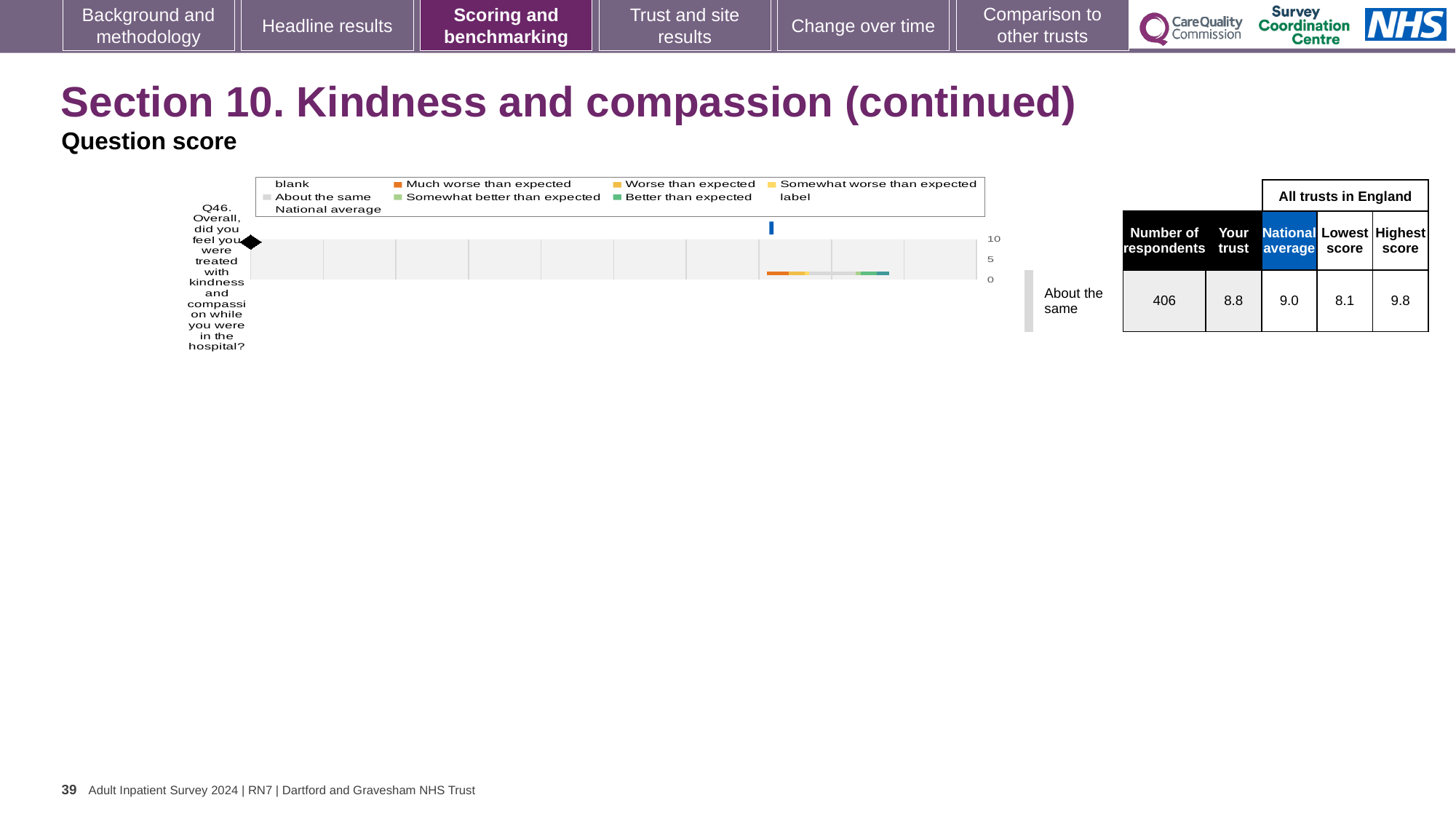
What kind of chart is shown for Q46 on the slide? bar chart Which is larger for Q46: the 'Your trust' score or the national average? National average How many respondents answered Q46? 406 What is the 'Your trust' score for Q46? 8.8 What is the lowest score among all trusts in England for Q46? 8.1 What is the difference between the highest score and the lowest score for Q46? 1.7 What is the national average score for Q46? 9.0 Is the 'Your trust' score for Q46 greater or less than 5? greater What is the highest score among all trusts in England for Q46? 9.8 How many survey questions are plotted in the chart? 1 What benchmark category is the trust's Q46 result placed in? About the same What is the highest value shown on the chart's axis? 10